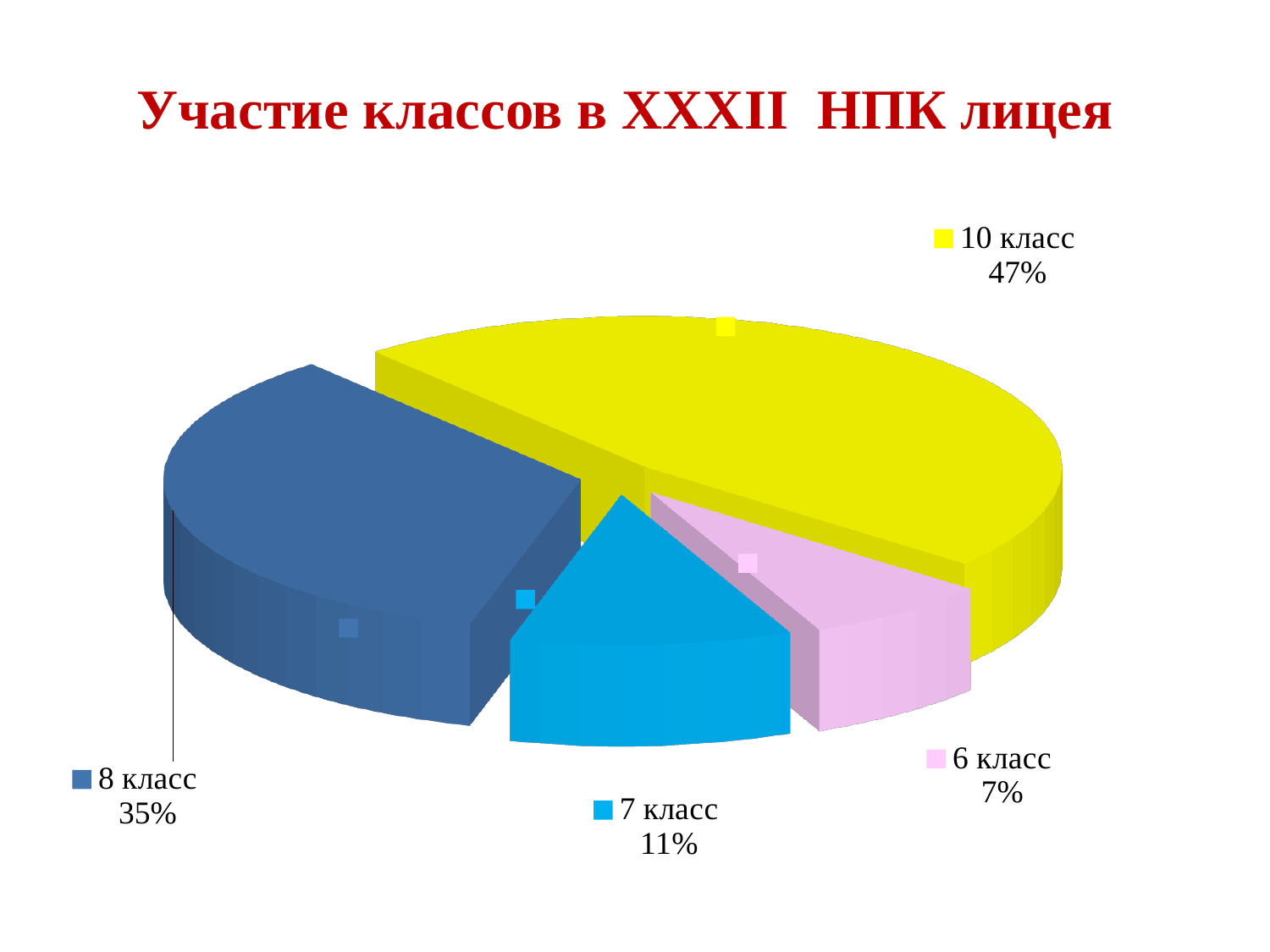
What is the value shown for 6 класс? 7% What kind of chart is shown on the slide? Pie chart Which class has the largest slice of the pie? 10 класс What is the value shown for 8 класс? 35% Which is larger, the share of 7 класс or the share of 6 класс? 7 класс What is the difference between the shares of 10 класс and 8 класс? 12% What is the value shown for 7 класс? 11% What colour is the slice for 10 класс? Yellow Which class has the smallest slice of the pie? 6 класс What share of the pie does 10 класс have? 47% What is the title of the slide? Участие классов в XXXII НПК лицея How many slices does the pie chart have? 4